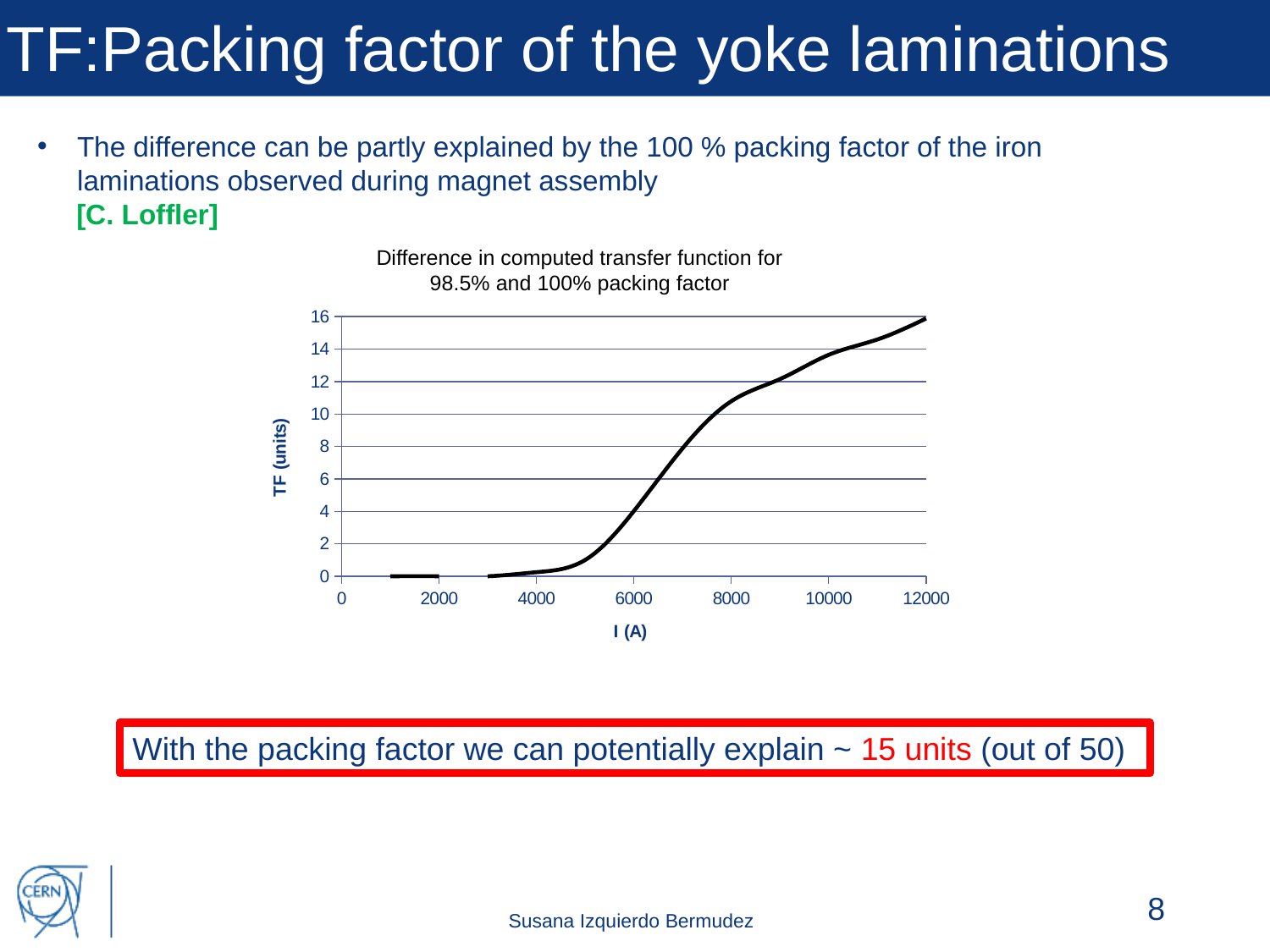
What is the title of the chart? Difference in computed transfer function for 98.5% and 100% packing factor How many lines (series) are plotted on the chart? 1 What kind of chart is shown on the slide? line chart Is the TF value at I = 6000 A greater or less than 6? less Is the TF value at I = 6000 A greater or less than 2? greater Is the TF value at I = 4000 A greater or less than 2? less Does the plotted TF value rise or fall as the current I increases along the x axis? rise What is the label of the x axis of the chart? I (A)